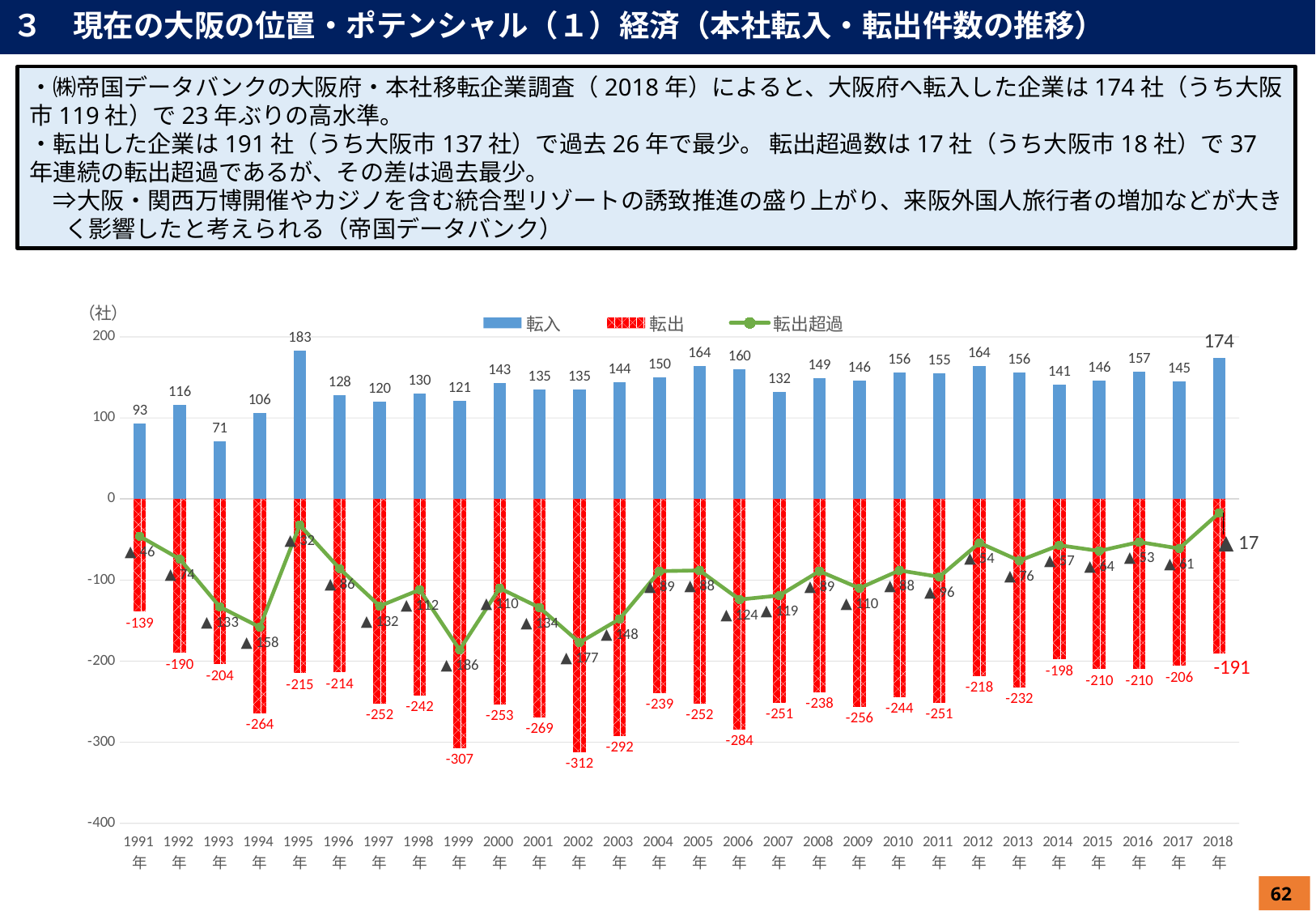
How many series does the legend list? 3 What are the three legend entries of the chart? 転入, 転出, 転出超過 What is the 転入 value for 2018年? 174 What is the 転出超過 value shown for 2018年? ▲ 17 How many years are shown on the x axis? 28 Which year has the lowest (most negative) 転出 value? 2002年 What is the difference between the 転入 values for 2018年 and 2017年? 29 Which year has the highest 転入 value? 1995年 Which year has the larger 転入 value, 2005年 or 2006年? 2005年 Which year has the lowest 転入 value? 1993年 What kind of chart is shown on the slide? Combined bar and line chart What is the 転出 value for 2002年? -312